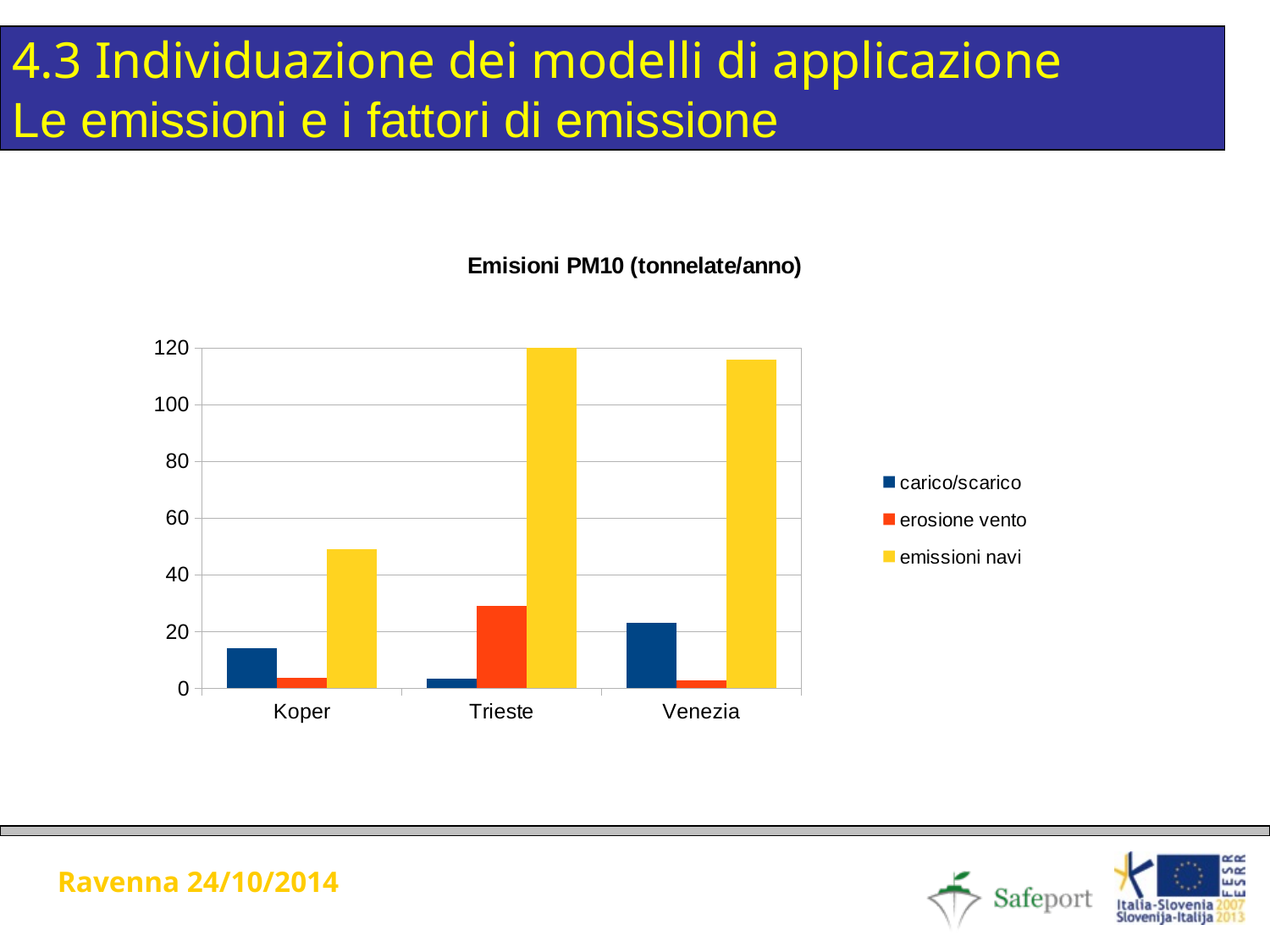
How many ports (categories) are shown on the x axis of the chart? 3 Which port has the lowest value for emissioni navi? Koper What kind of chart is shown on the slide? bar chart Which port has the highest value for erosione vento? Trieste Which port has the lowest value for carico/scarico? Trieste Which series is shown in yellow in the chart? emissioni navi Which port has the highest value for emissioni navi? Trieste Is the value for emissioni navi at Koper greater or less than 40? greater How many series does the chart legend list? 3 What is the title of the chart? Emisioni PM10 (tonnelate/anno) Which is larger: carico/scarico at Venezia or carico/scarico at Trieste? Venezia Is the value for emissioni navi at Venezia greater or less than 100? greater